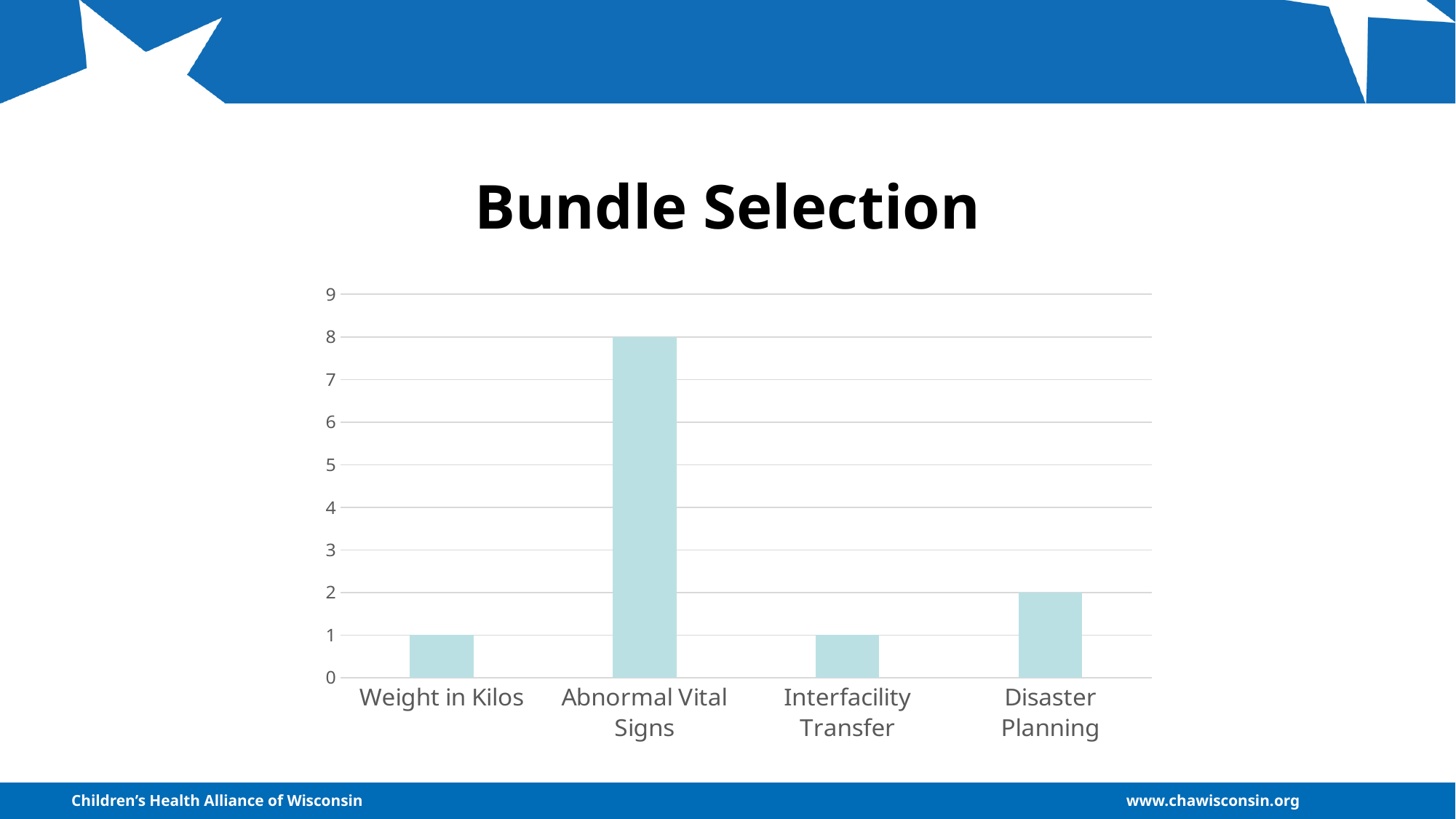
How many categories are shown on the x axis? 4 What is the value for Disaster Planning? 2 Which is larger, the value for Disaster Planning or the value for Interfacility Transfer? Disaster Planning What is the difference between the values for Disaster Planning and Weight in Kilos? 1 Is the value for Abnormal Vital Signs greater or less than 5? greater What is the value for Weight in Kilos? 1 Which category has the highest value? Abnormal Vital Signs What is the title of the chart? Bundle Selection What is the value for Interfacility Transfer? 1 What kind of chart is shown on the slide? bar chart What is the value for Abnormal Vital Signs? 8 What is the difference between the values for Abnormal Vital Signs and Disaster Planning? 6